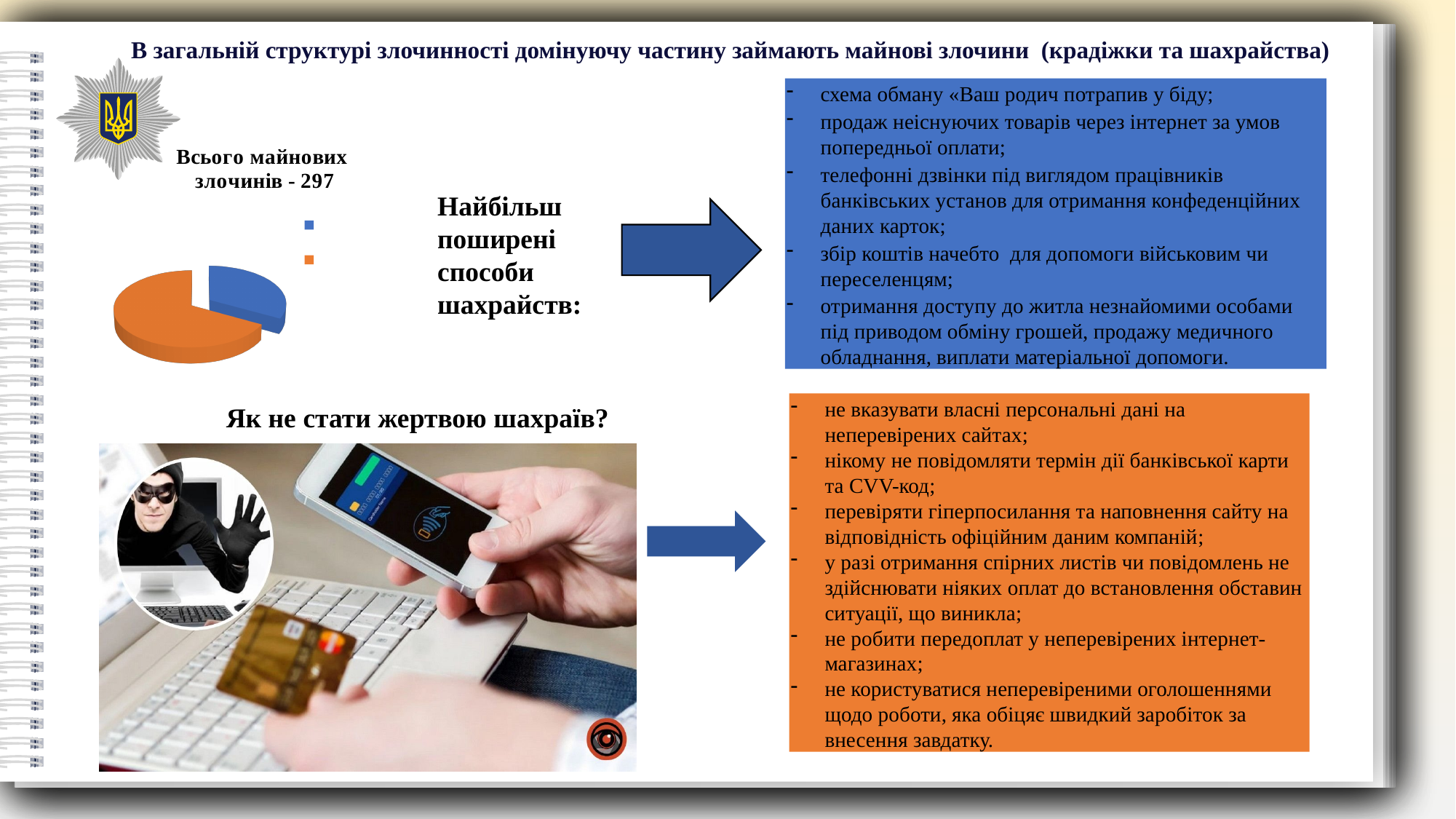
What is the title shown above the pie chart? Всього майнових злочинів - 297 Which slice of the pie chart is larger, the orange one or the blue one? the orange one Which slice of the pie chart is the smallest? the blue slice What kind of chart is shown on the slide? pie chart What total number of property crimes is stated in the pie chart's title? 297 How many slices does the pie chart have? 2 How many entries does the legend of the pie chart list? 2